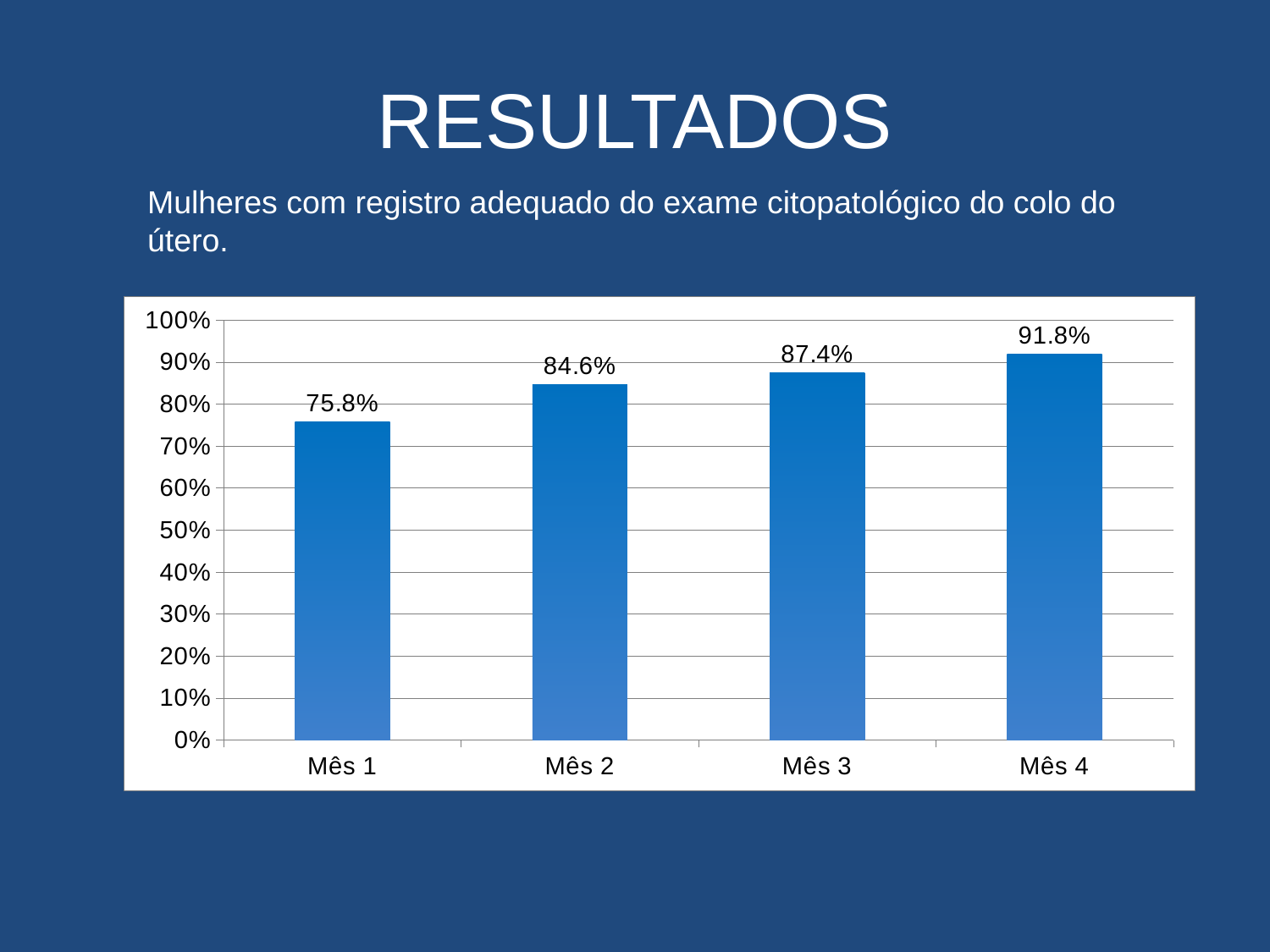
What is the difference between the values for Mês 3 and Mês 2? 2.8 percentage points What is the value for Mês 2? 84.6% How many months are shown on the x axis? 4 Which month has the highest value? Mês 4 What is the value for Mês 4? 91.8% Do the values rise or fall from Mês 1 to Mês 4? Rise What kind of chart is shown on the slide? Bar chart What is the value for Mês 3? 87.4% What is the difference between the values for Mês 4 and Mês 1? 16 percentage points What is the value for Mês 1? 75.8% Which month has the lowest value? Mês 1 Which is larger, the value for Mês 2 or the value for Mês 3? Mês 3